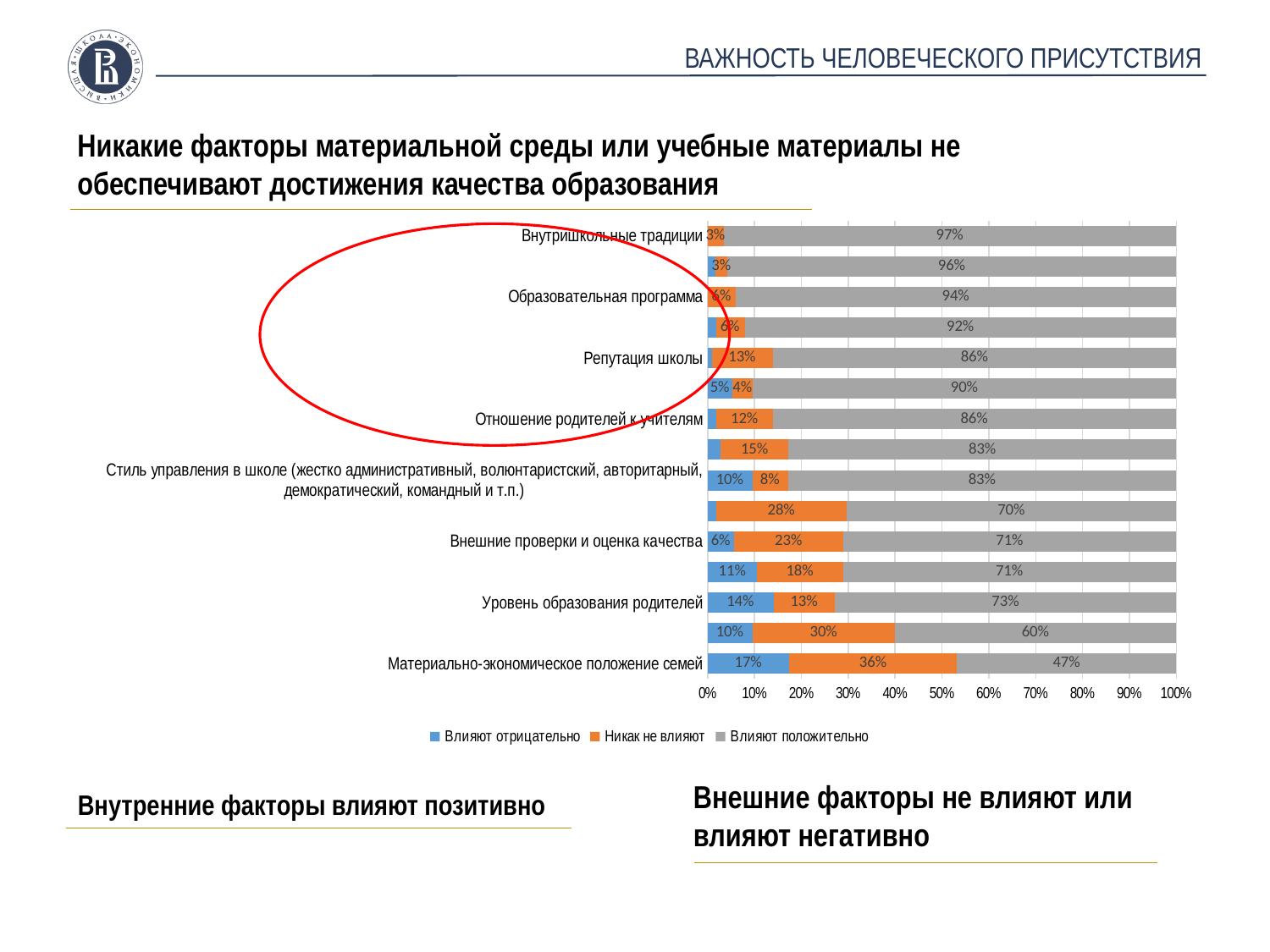
What is the value of the Влияют положительно series for Внешние проверки и оценка качества? 71% What kind of chart is shown on the slide? Stacked bar chart Which labelled category has the highest value for Влияют положительно? Внутришкольные традиции Which series is shown in grey in the legend? Влияют положительно How many series does the legend list? 3 What percentage of respondents say that Внутришкольные традиции influence positively (Влияют положительно)? 97% Which has a larger Влияют отрицательно value: Уровень образования родителей or Внешние проверки и оценка качества? Уровень образования родителей Which labelled category has the lowest value for Влияют положительно? Материально-экономическое положение семей What is the value of the Никак не влияют series for Материально-экономическое положение семей? 36% What is the difference in percentage points between the Влияют положительно values for Внутришкольные традиции and Материально-экономическое положение семей? 50 percentage points What is the total of the stacked bar for Материально-экономическое положение семей? 100% What is the value of the Влияют отрицательно series for Уровень образования родителей? 14%